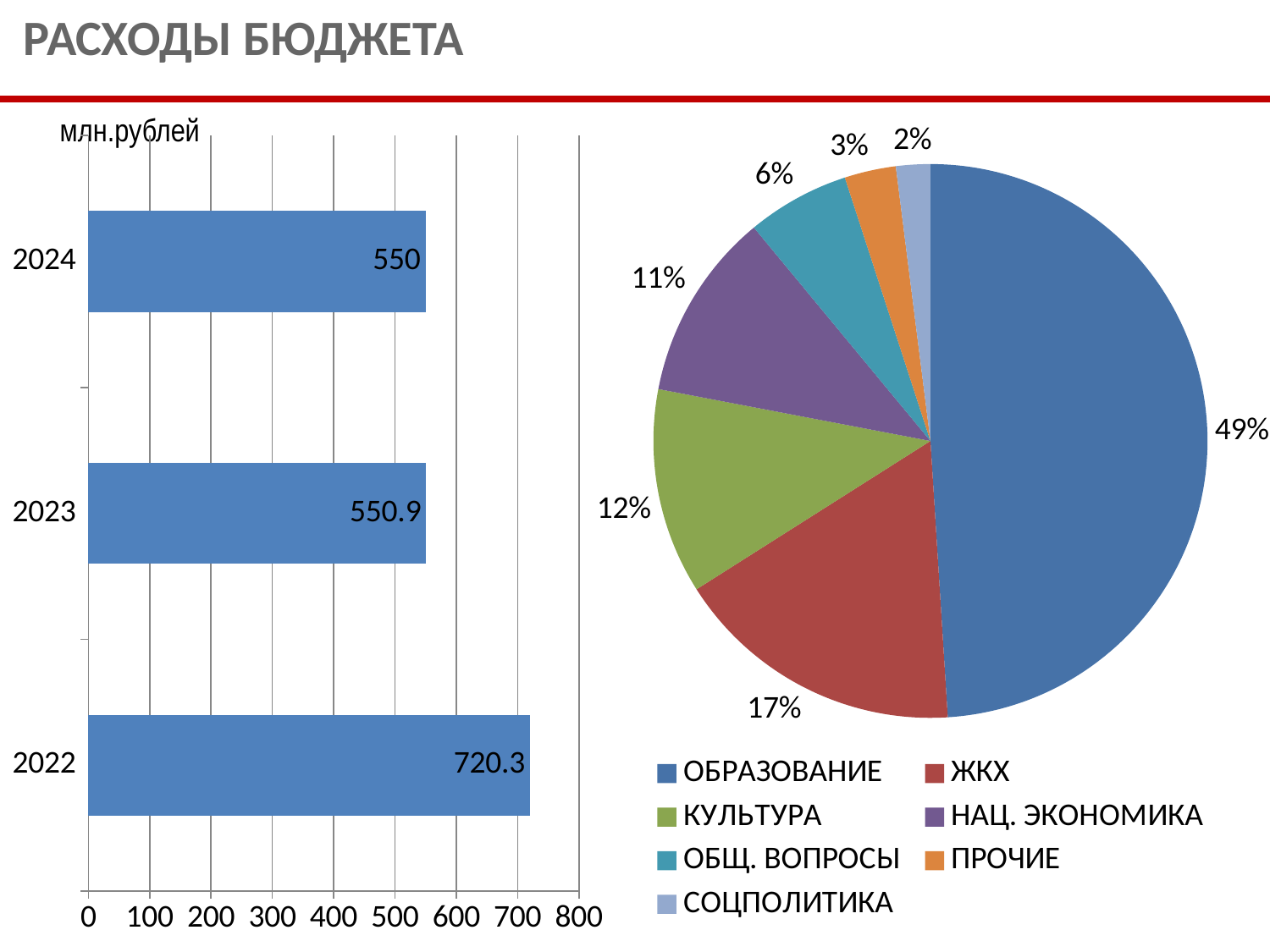
In the pie chart on the right, what share does ЖКХ have? 17% In the bar chart on the left, which year has the highest value? 2022 In the bar chart on the left, what is the value for 2022? 720.3 In the bar chart on the left, what is the value for 2023? 550.9 What kind of chart is the chart on the left? bar chart In the pie chart on the right, which is larger: КУЛЬТУРА or НАЦ. ЭКОНОМИКА? КУЛЬТУРА In the pie chart on the right, how many categories does the legend list? 7 In the bar chart on the left, how many years are shown? 3 In the pie chart on the right, which category has the smallest share? СОЦПОЛИТИКА In the bar chart on the left, what unit is shown above the chart? млн.рублей In the bar chart on the left, what is the difference between the values for 2022 and 2024? 170.3 In the pie chart on the right, what share does ОБРАЗОВАНИЕ have? 49%